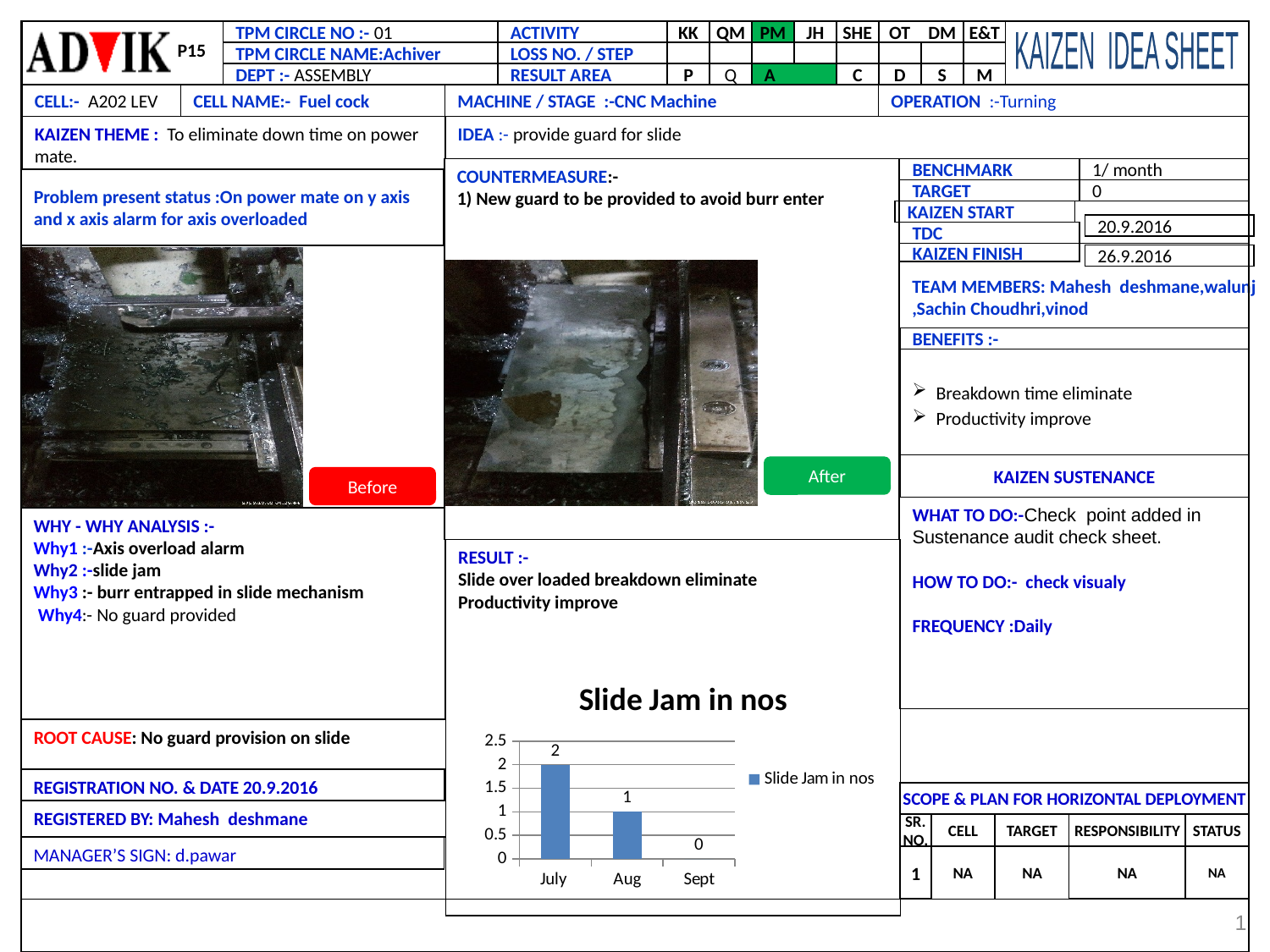
Which is larger in the Slide Jam in nos chart, the value for July or the value for Sept? July What is the difference between the July and Aug values in the Slide Jam in nos chart? 1 Do the values in the Slide Jam in nos chart rise or fall from July to Sept? fall How many months are shown on the x axis of the Slide Jam in nos chart? 3 What is the value for Aug in the Slide Jam in nos chart? 1 What is the value for July in the Slide Jam in nos chart? 2 What kind of chart is the Slide Jam in nos chart? bar chart Is the value for July in the Slide Jam in nos chart greater or less than 1.5? greater How many series does the legend of the Slide Jam in nos chart list? 1 Which month has the highest value in the Slide Jam in nos chart? July Which month has the lowest value in the Slide Jam in nos chart? Sept What is the value for Sept in the Slide Jam in nos chart? 0